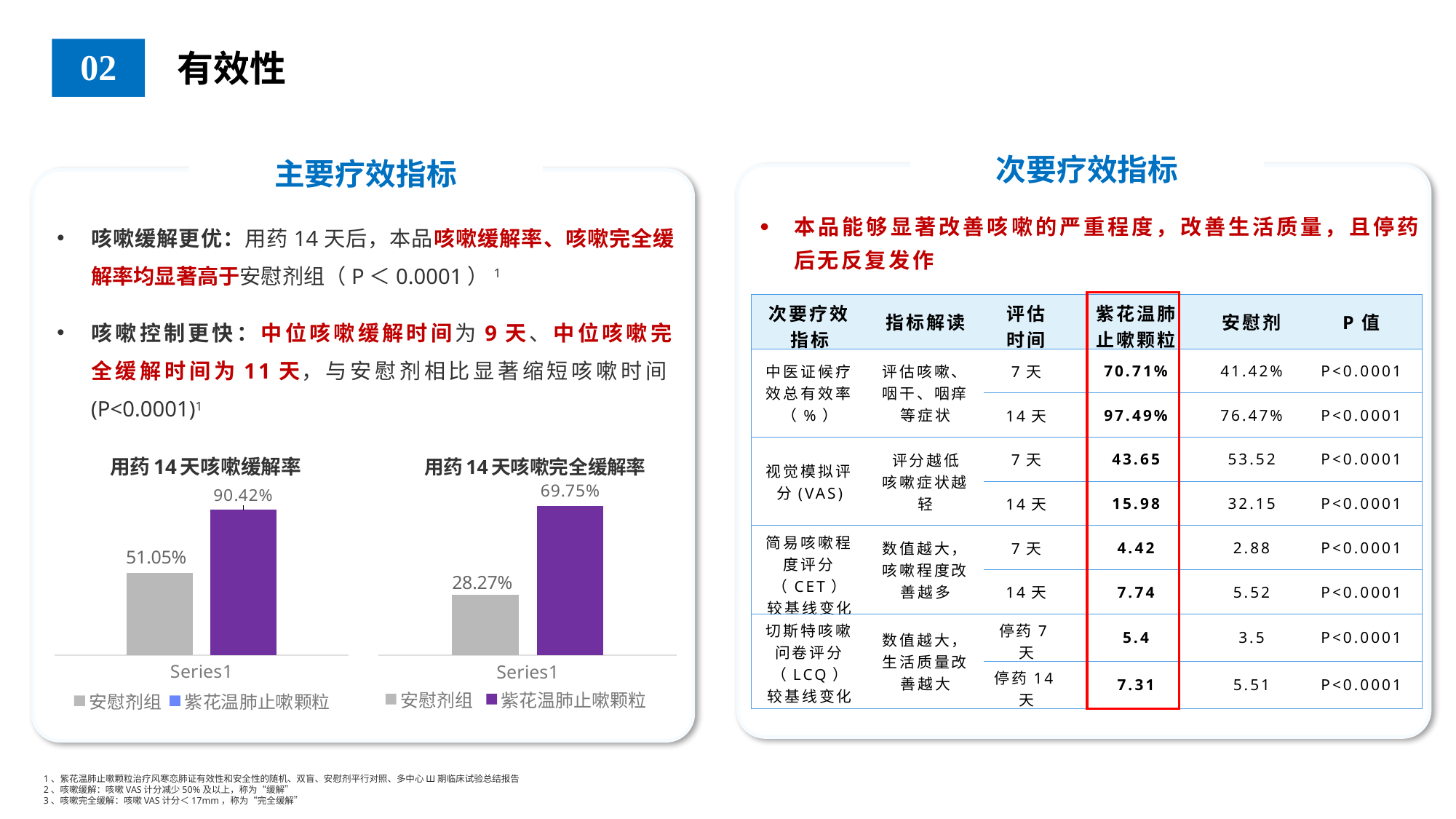
In the chart titled 用药14天咳嗽缓解率, what is the value for 紫花温肺止嗽颗粒? 90.42% In the chart titled 用药14天咳嗽完全缓解率, which series has the lower value? 安慰剂组 In the chart titled 用药14天咳嗽完全缓解率, what is the value for 紫花温肺止嗽颗粒? 69.75% In the chart titled 用药14天咳嗽完全缓解率, what is the value for 安慰剂组? 28.27% What kind of chart is the chart titled 用药14天咳嗽缓解率? bar chart In the chart titled 用药14天咳嗽缓解率, what is the difference between the 紫花温肺止嗽颗粒 value and the 安慰剂组 value? 39.37% In the chart titled 用药14天咳嗽完全缓解率, what is the difference between the 紫花温肺止嗽颗粒 value and the 安慰剂组 value? 41.48% In the chart titled 用药14天咳嗽缓解率, which series has the higher value? 紫花温肺止嗽颗粒 How many series does the legend of the chart titled 用药14天咳嗽完全缓解率 list? 2 In the chart titled 用药14天咳嗽缓解率, what is the value for 安慰剂组? 51.05% Is the 安慰剂组 value in the chart titled 用药14天咳嗽缓解率 larger or smaller than the 安慰剂组 value in the chart titled 用药14天咳嗽完全缓解率? larger In the chart titled 用药14天咳嗽完全缓解率, what colour is the bar for 紫花温肺止嗽颗粒? purple